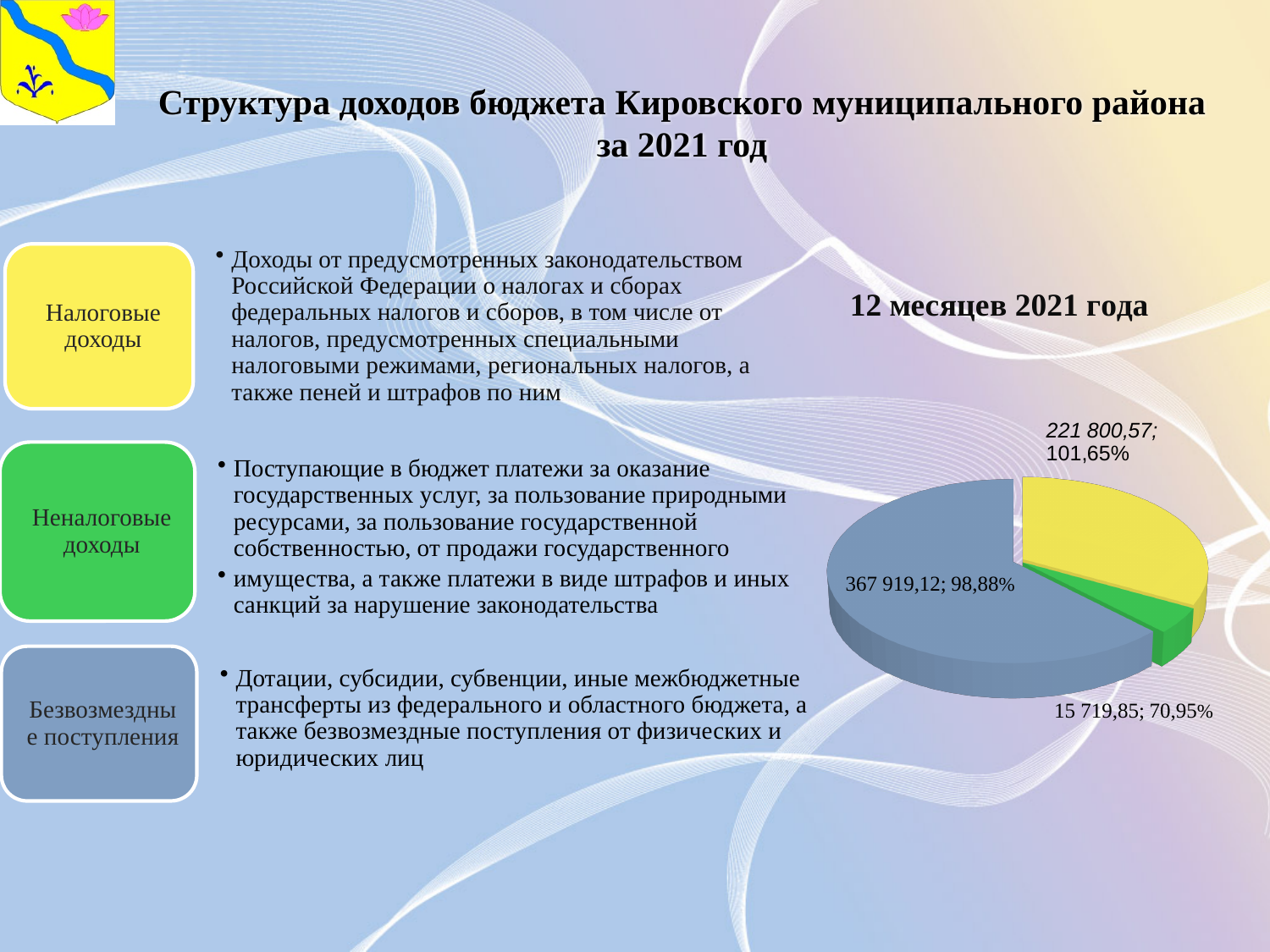
What value is labelled on the yellow slice of the pie chart? 221 800,57 What kind of chart is shown on the slide? pie chart What percentage is labelled on the blue-grey slice of the pie chart? 98,88% How many slices does the pie chart have? 3 Which slice of the pie chart has the largest value? the blue-grey slice (367 919,12) Which is larger in the pie chart: the yellow slice value or the green slice value? the yellow slice (221 800,57) Which slice of the pie chart has the smallest value? the green slice (15 719,85) What is the difference between the blue-grey slice value (367 919,12) and the yellow slice value (221 800,57)? 146 118,55 What is the title shown above the pie chart? 12 месяцев 2021 года What percentage is labelled on the yellow slice of the pie chart? 101,65% Which colour in the pie chart corresponds to the box labelled 'Неналоговые доходы' on the left of the slide? green What value is labelled on the green slice of the pie chart? 15 719,85